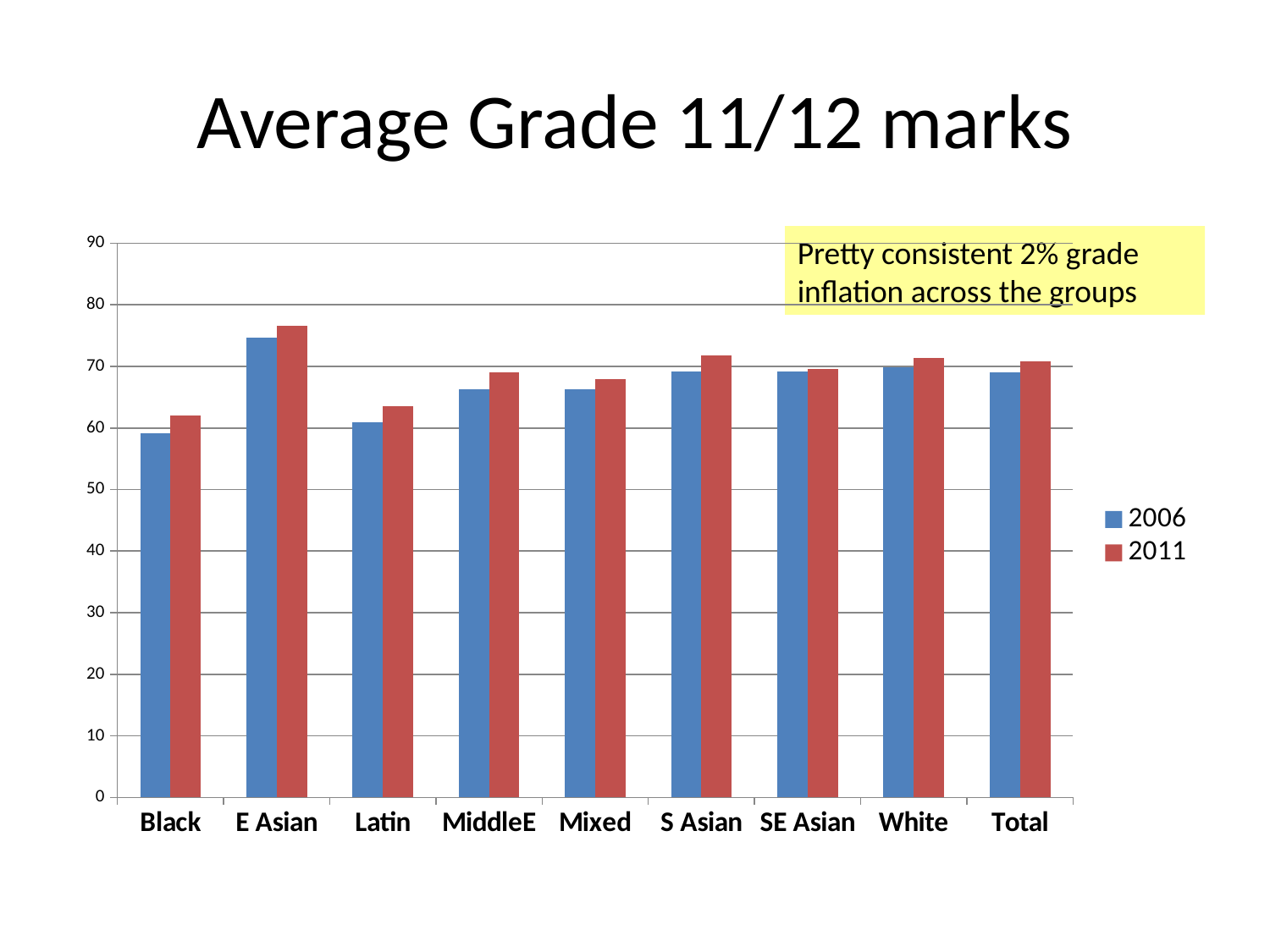
Is the 2006 value for Mixed greater or less than 70? less Is the 2006 value for E Asian greater or less than 70? greater How many series does the legend list? 2 For Black, which is larger: the 2006 value or the 2011 value? 2011 Is the 2011 value for E Asian greater or less than 80? less Which category has the lowest 2006 value? Black What is the title of the slide? Average Grade 11/12 marks What kind of chart is shown on the slide? bar chart Which category has the highest 2011 value? E Asian How many categories are shown on the x axis? 9 Which series is shown in red? 2011